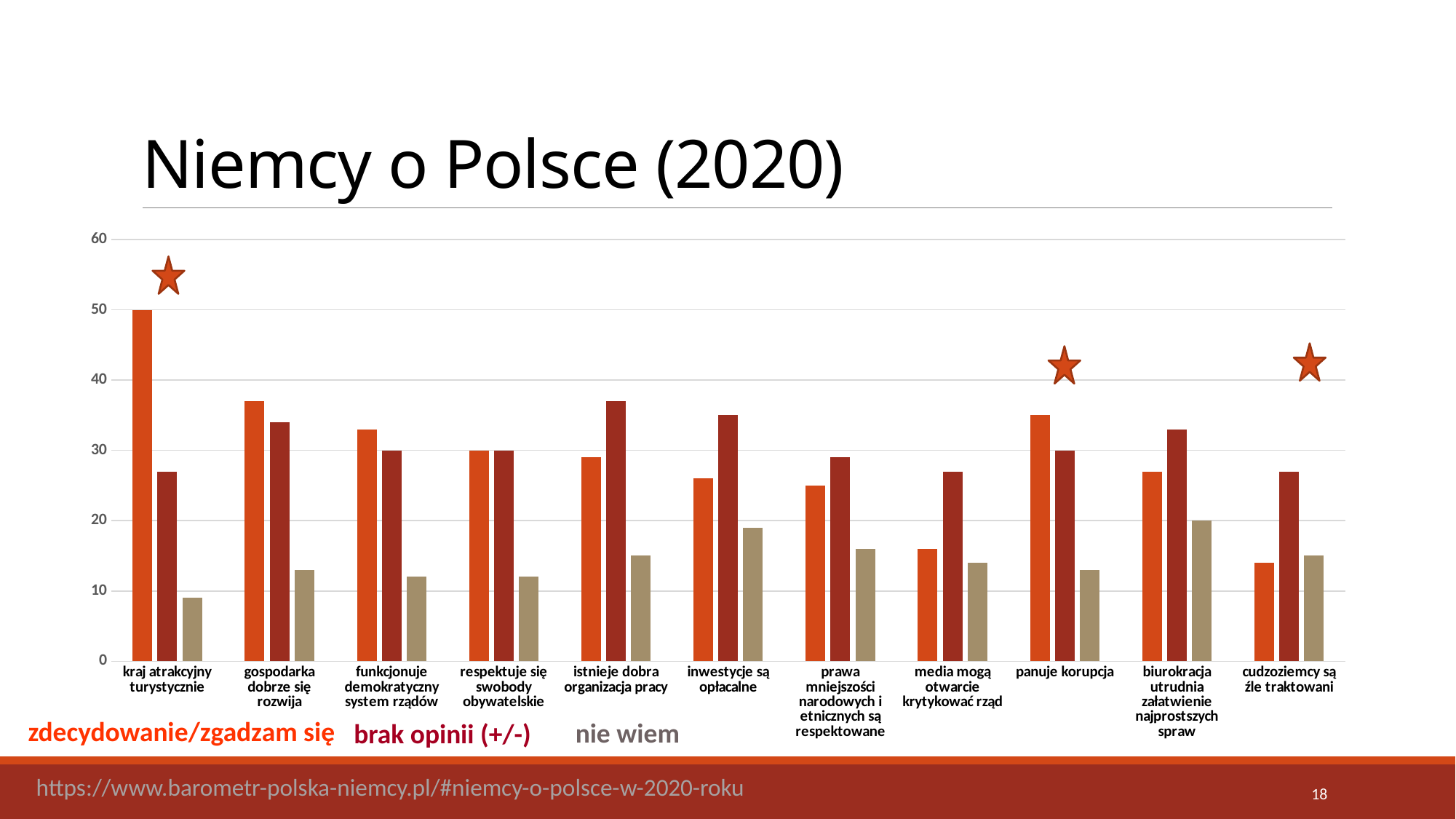
Which category has the highest value for the 'zdecydowanie/zgadzam się' series? kraj atrakcyjny turystycznie Is the 'nie wiem' value for 'kraj atrakcyjny turystycznie' greater or less than 10? less Is the 'brak opinii (+/-)' value for 'panuje korupcja' greater or less than 40? less Is the 'zdecydowanie/zgadzam się' value for 'panuje korupcja' greater or less than 30? greater What kind of chart is shown on the slide? bar chart What is the title of the slide containing the chart? Niemcy o Polsce (2020) For 'istnieje dobra organizacja pracy', which is larger: the 'zdecydowanie/zgadzam się' value or the 'brak opinii (+/-)' value? brak opinii (+/-) How many series does the chart's legend list? 3 What is the 'zdecydowanie/zgadzam się' value for 'kraj atrakcyjny turystycznie'? 50 How many categories (statements) are shown along the x axis of the chart? 11 For 'inwestycje są opłacalne', which is larger: the 'zdecydowanie/zgadzam się' value or the 'brak opinii (+/-)' value? brak opinii (+/-) Which colour represents the 'nie wiem' series in the chart? grey